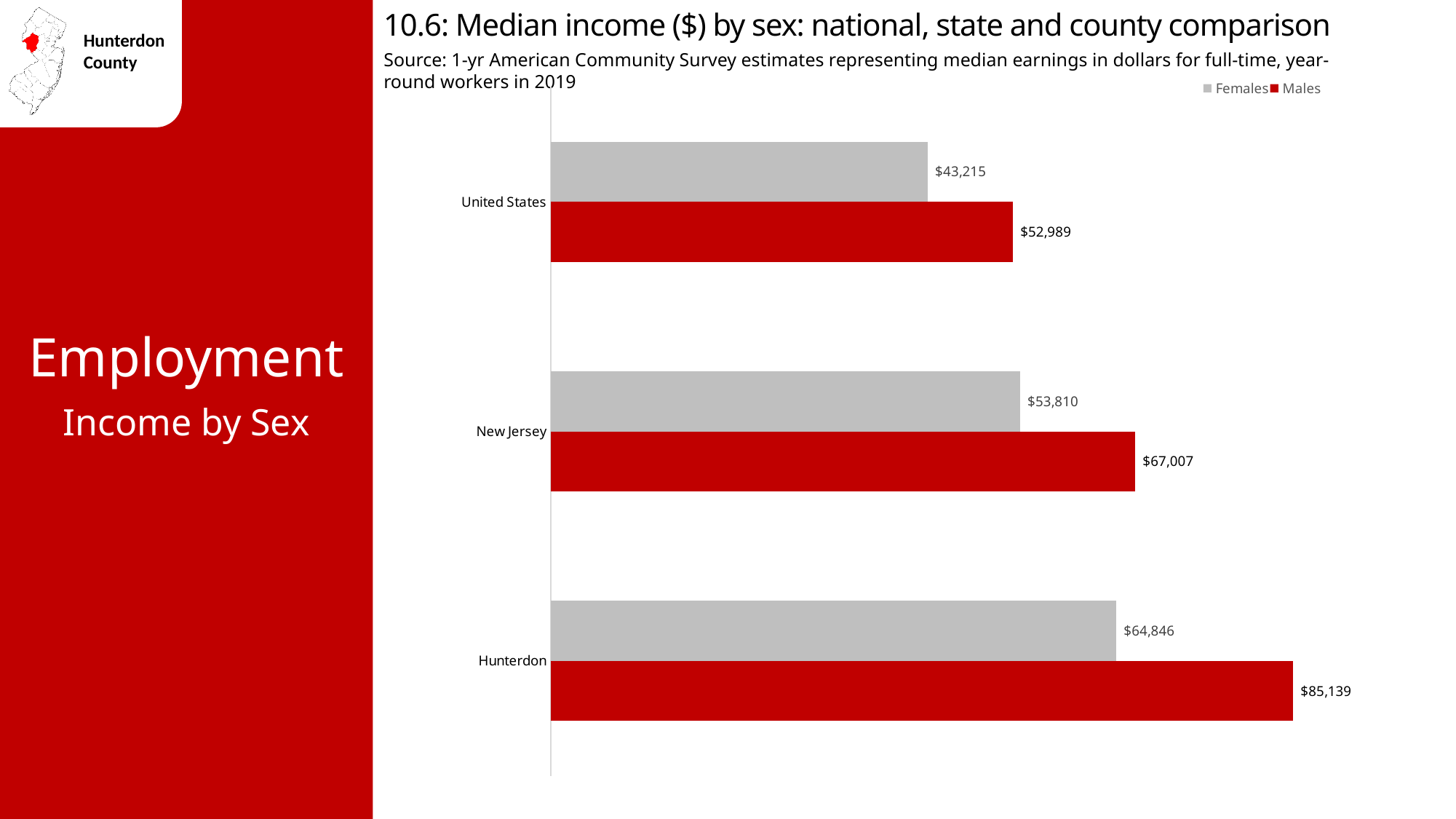
Which area has the highest median income for males? Hunterdon What is the median income for males in New Jersey? $67,007 How many areas are compared in the chart? 3 What is the difference between male and female median income in the United States? $9,774 Which is larger: the female median income in Hunterdon or the male median income in New Jersey? Male median income in New Jersey What kind of chart is shown on the slide? Bar chart Which area has the lowest median income for females? United States What is the median income for females in Hunterdon? $64,846 How many series does the legend list? 2 What is the median income for males in Hunterdon? $85,139 What is the difference between male and female median income in Hunterdon? $20,293 What is the median income for females in the United States? $43,215